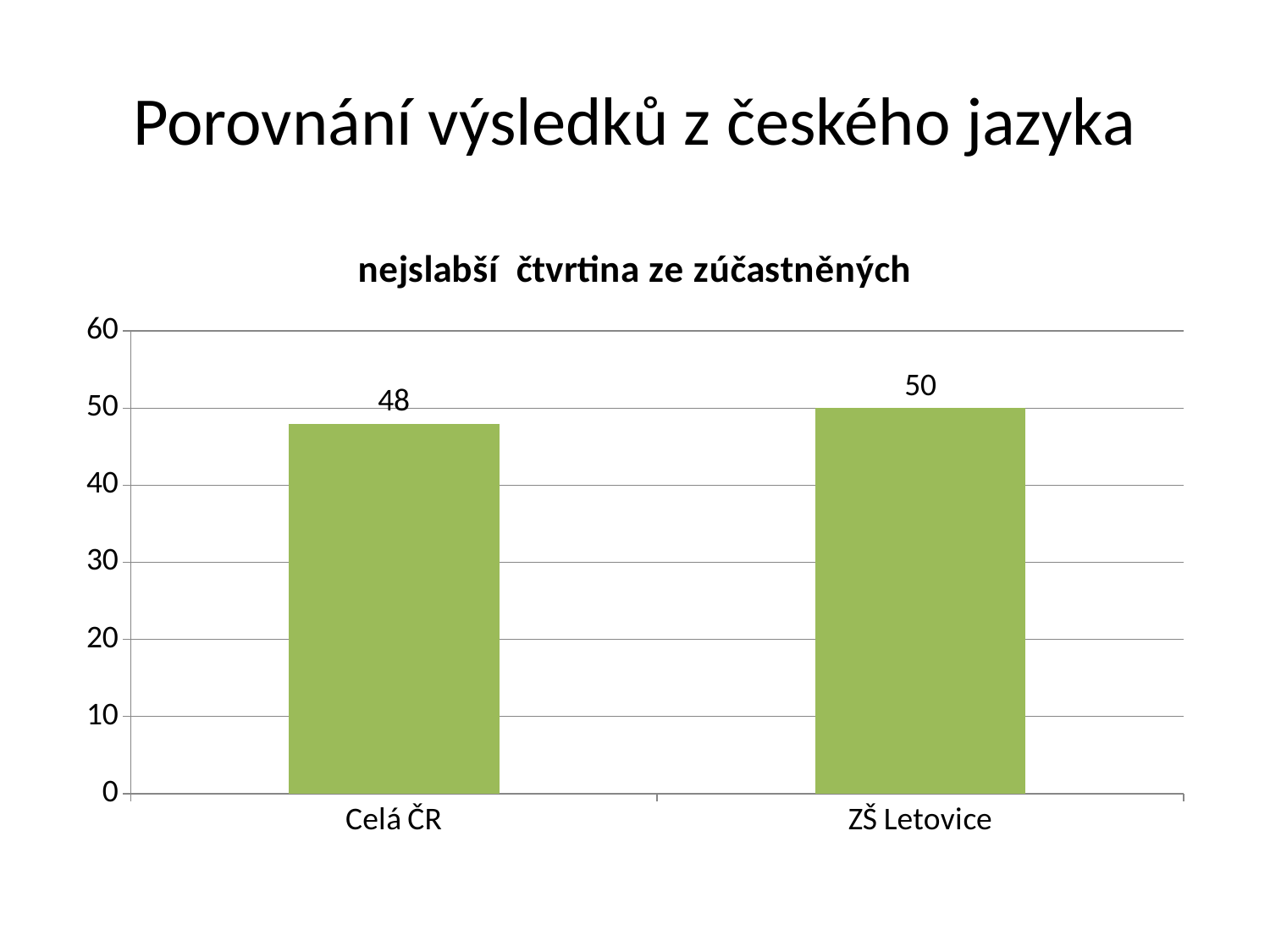
What is the value for ZŠ Letovice? 50 How many categories are shown in the chart? 2 What is the value for Celá ČR? 48 What kind of chart is shown on the slide? bar chart What is the highest value shown on the vertical axis? 60 Is the value for ZŠ Letovice greater or less than 60? less Which category has the lowest value? Celá ČR Is the value for Celá ČR greater or less than 40? greater Which is larger, the value for Celá ČR or the value for ZŠ Letovice? ZŠ Letovice Which category has the highest value? ZŠ Letovice What is the title of the chart? nejslabší čtvrtina ze zúčastněných What is the difference between the values for ZŠ Letovice and Celá ČR? 2